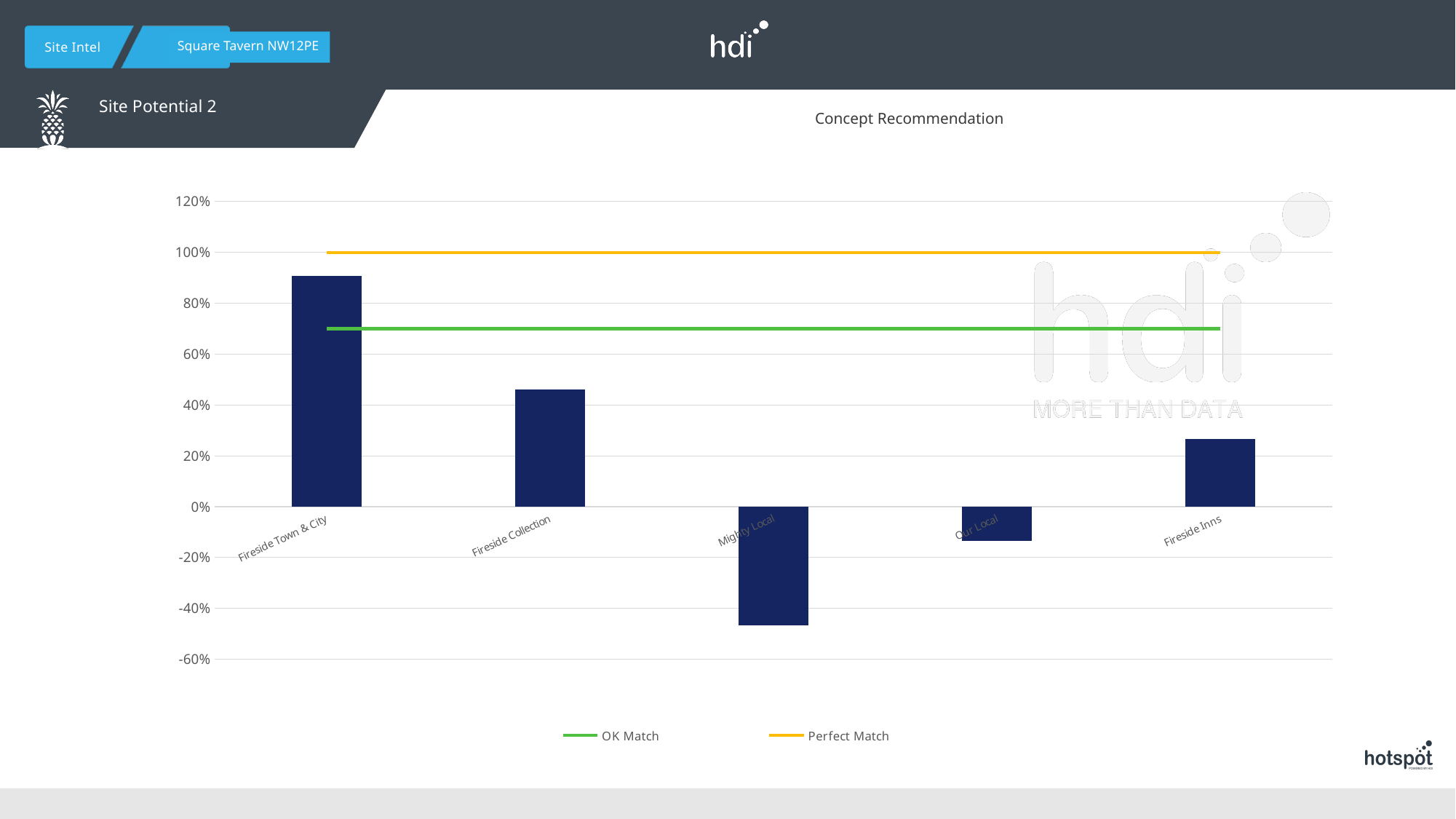
Is the value for Fireside Collection greater or less than 60%? less Is the value for Fireside Town & City greater or less than 80%? greater At what value does the Perfect Match line sit on the chart? 100% What is the title shown above the chart? Concept Recommendation Is the value for Mighty Local greater or less than -20%? less Which category has the highest bar in the chart? Fireside Town & City Which is larger, the value for Fireside Inns or the value for Our Local? Fireside Inns Which category has the lowest bar in the chart? Mighty Local What kind of chart is shown on the slide? bar chart How many categories are plotted on the x axis of the chart? 5 Is the OK Match line above or below the Perfect Match line? below How many series does the chart's legend list? 2